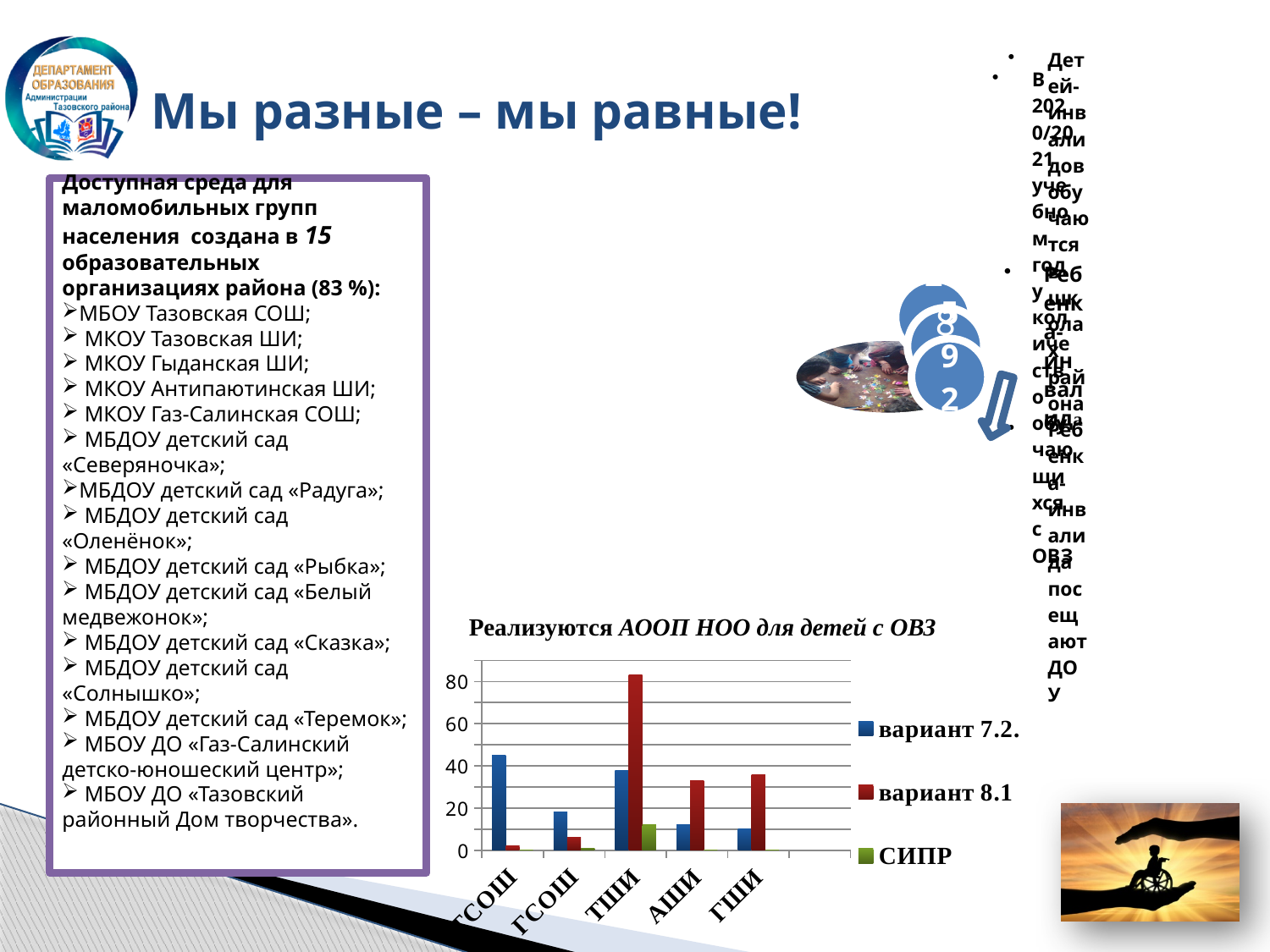
What is the title of the chart on the slide? Реализуются АООП НОО для детей с ОВЗ How many categories are shown on the x axis of the chart? 5 Is the value for "вариант 7.2." at ТСОШ greater or less than 40? greater At ТШИ, which series has the larger value: "вариант 7.2." or "вариант 8.1"? вариант 8.1 Which category has the highest value for the series "вариант 7.2."? ТСОШ At ТСОШ, which series has the larger value: "вариант 7.2." or "вариант 8.1"? вариант 7.2. Which category has the highest value for the series "СИПР"? ТШИ Is the value for "вариант 8.1" at ТШИ greater or less than 60? greater What kind of chart is shown under the title "Реализуются АООП НОО для детей с ОВЗ"? bar chart Which category has the highest value for the series "вариант 8.1"? ТШИ How many series does the chart legend list? 3